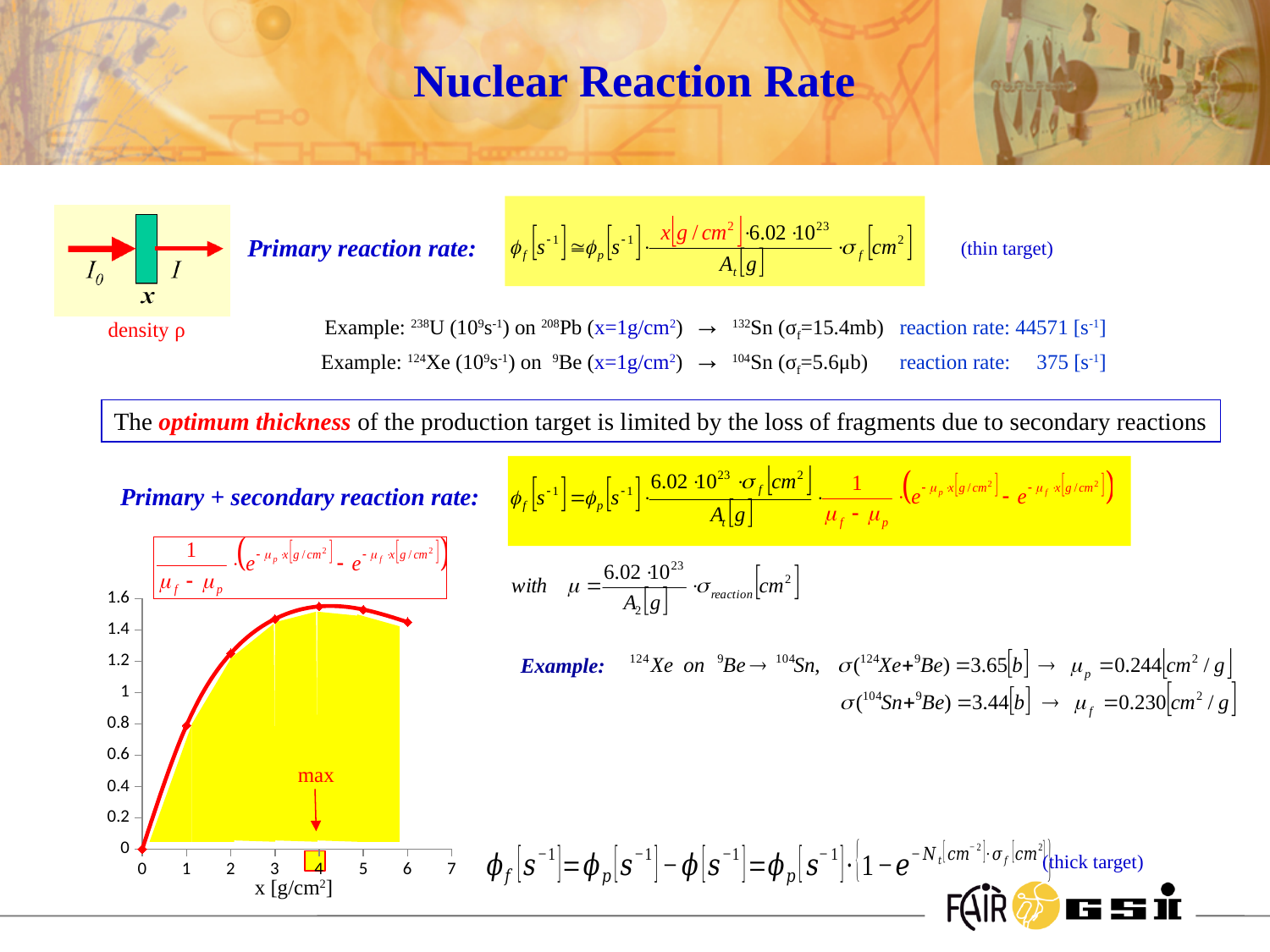
Is the value at x = 6 greater or less than 1.6? less Which is larger, the value at x = 1 or the value at x = 2? x = 2 Is the value at x = 2 greater or less than 1? greater At which x value is the 'max' annotation placed on the chart? 4 How many marked data points does the curve have? 7 What kind of chart is shown on the slide? line chart Does the curve rise or fall between x = 0 and x = 4? rise What is the label of the x axis of the chart? x [g/cm2] Is the value at x = 1 greater or less than 1? less Does the curve rise or fall between x = 4 and x = 6? fall At which x value is the curve lowest? 0